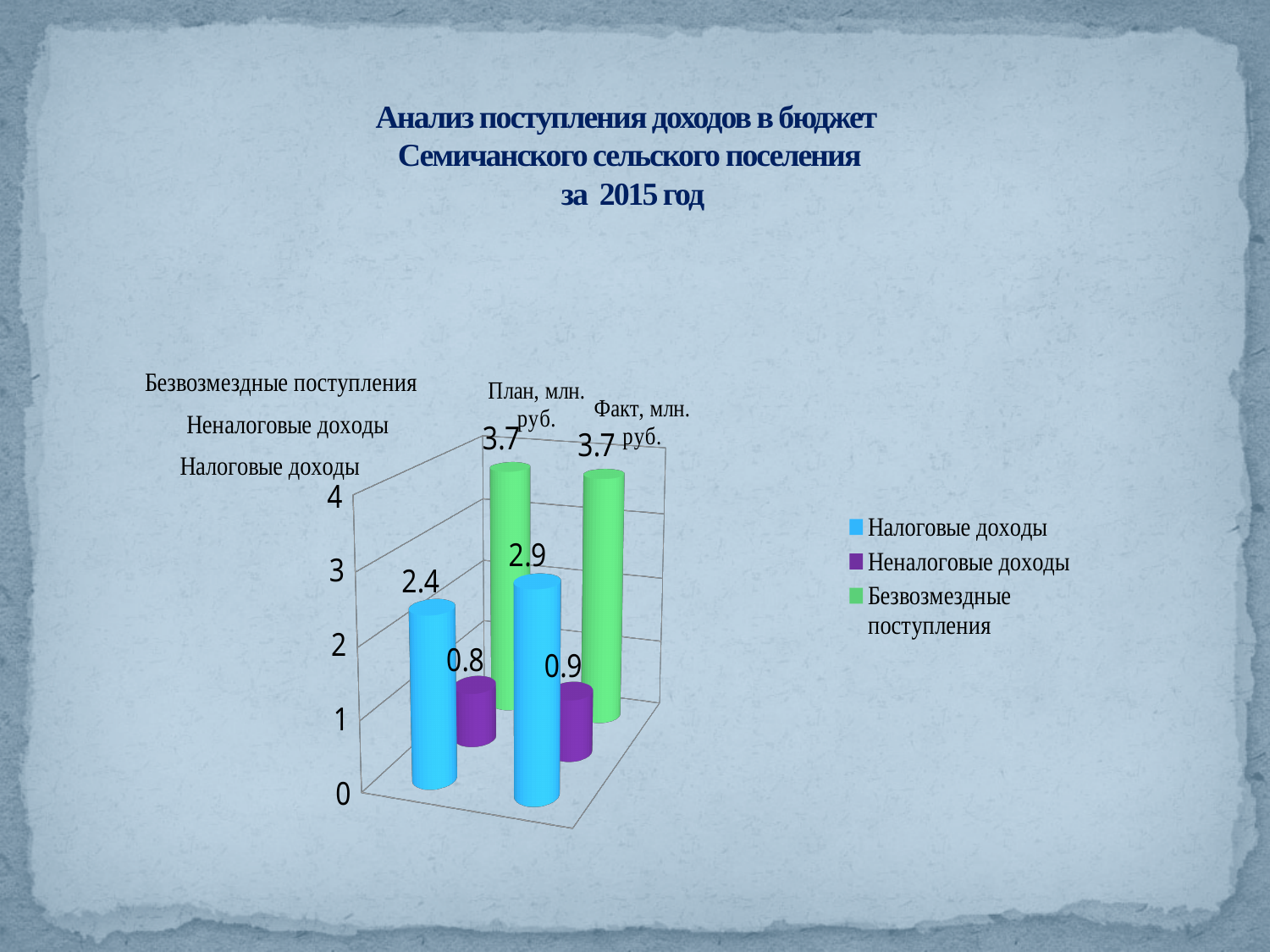
What is the value of Налоговые доходы for Факт, млн. руб.? 2.9 Which is larger: Налоговые доходы for План or Налоговые доходы for Факт? Факт What is the value of Неналоговые доходы for План, млн. руб.? 0.8 What is the difference between the Факт and План values for Налоговые доходы? 0.5 What kind of chart is shown on the slide? Bar chart Which series has the lowest value for Факт, млн. руб.? Неналоговые доходы What is the value of Неналоговые доходы for Факт, млн. руб.? 0.9 How many series does the legend list? 3 How many categories are shown on the x axis? 2 Which series has the highest value for План, млн. руб.? Безвозмездные поступления What is the value of Налоговые доходы for План, млн. руб.? 2.4 What is the value of Безвозмездные поступления for Факт, млн. руб.? 3.7